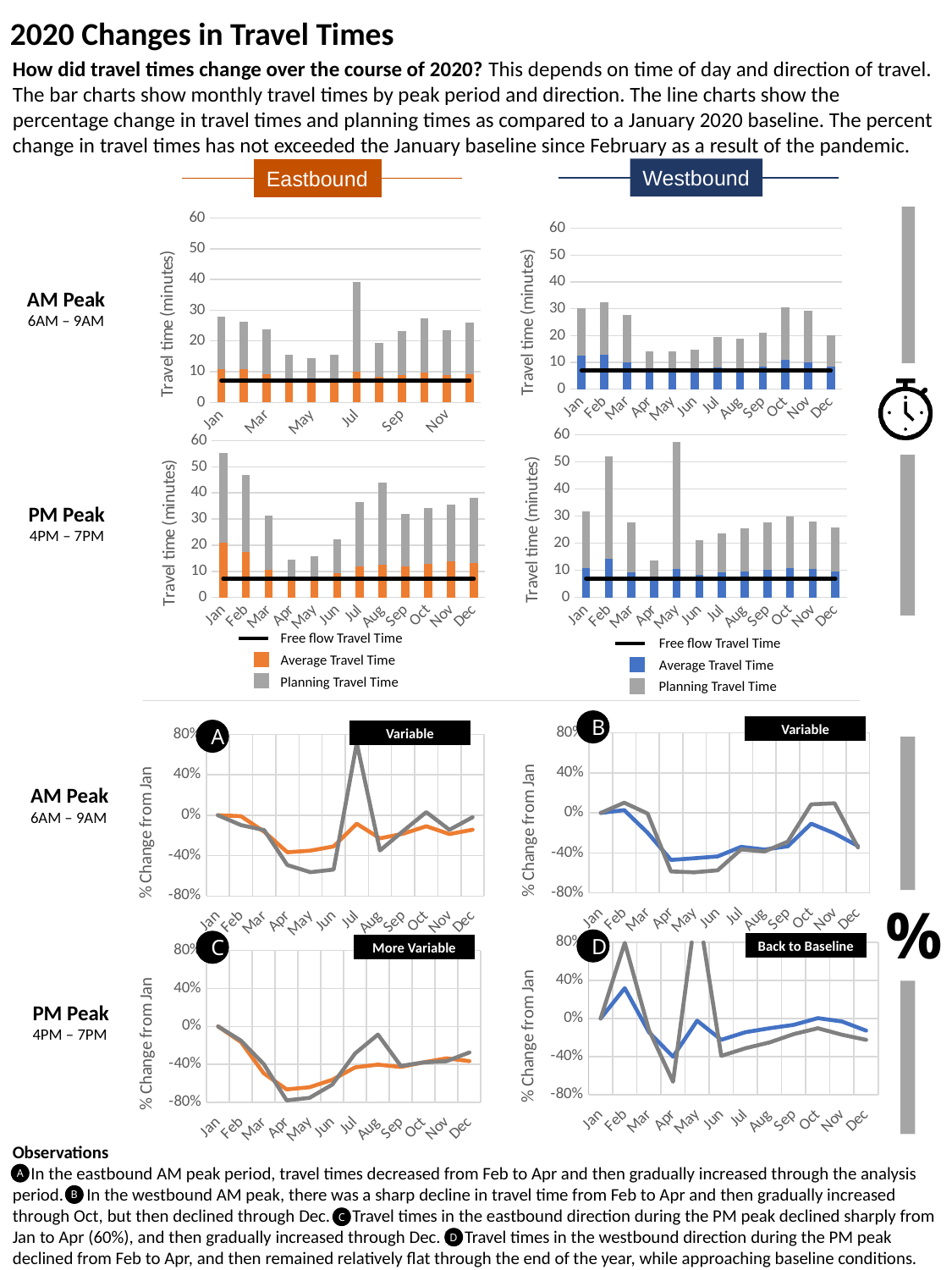
In the Eastbound PM Peak bar chart, which month has the highest planning travel time? Jan What kind of chart is chart C (Eastbound PM Peak % Change from Jan)? line chart In the Westbound PM Peak bar chart, which month has the lowest planning travel time? Apr In the Eastbound AM Peak bar chart, is the planning travel time for Jul greater or less than 30? greater How many months are shown on the x axis of the Eastbound AM Peak bar chart? 12 In the Westbound PM Peak bar chart, which month has the highest planning travel time? May In the Eastbound PM Peak bar chart, is the planning travel time for Jan greater or less than 50? greater In the Westbound AM Peak bar chart, which month has the highest planning travel time? Feb In the Westbound PM Peak bar chart, is the planning travel time for Feb greater or less than 40? greater In chart C (Eastbound PM Peak % Change from Jan), do the values rise or fall from Jan to Apr? fall How many entries does the legend below the Eastbound bar charts list? 3